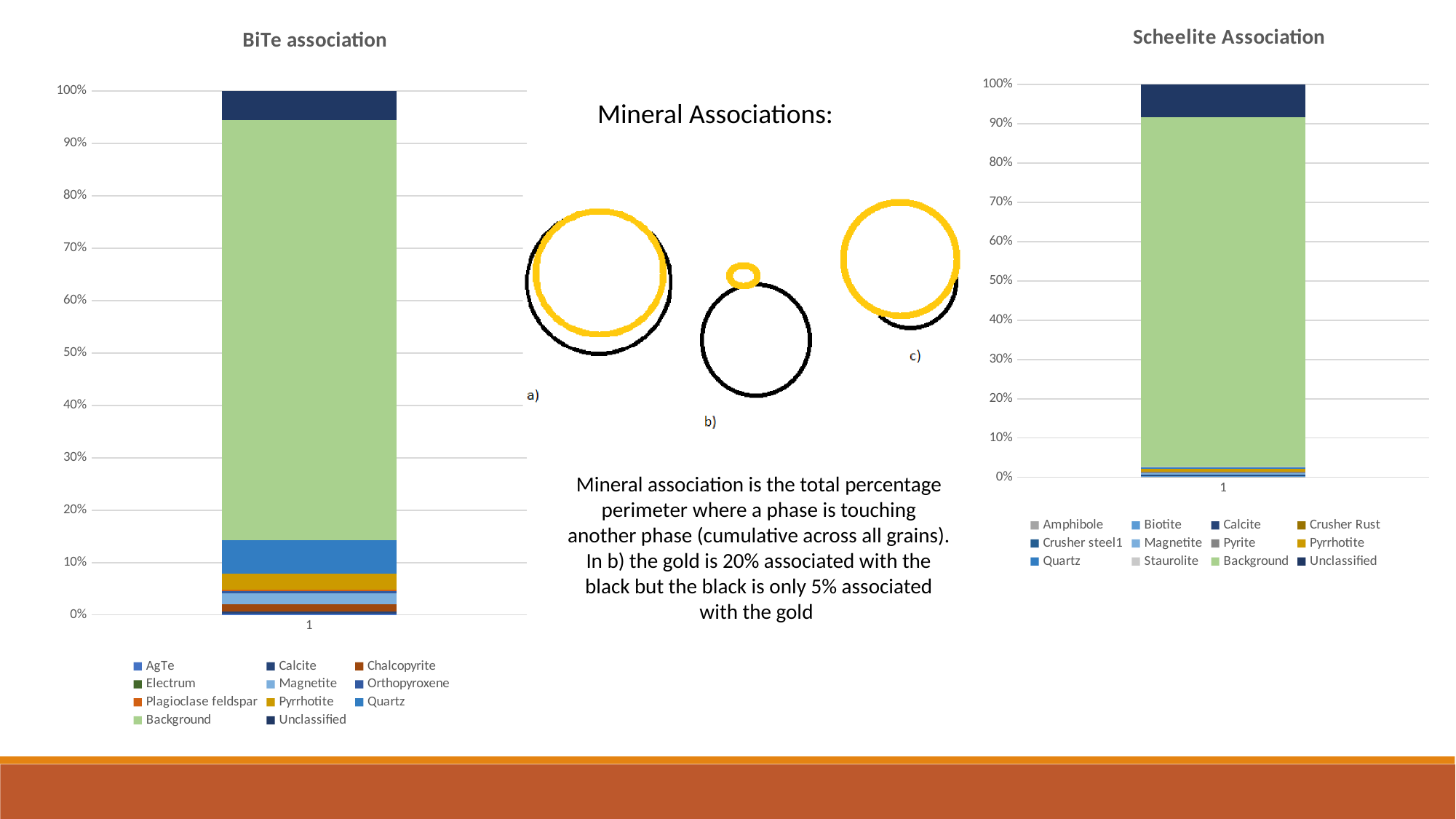
In the BiTe association chart, is the Quartz segment greater or less than 10%? less In the BiTe association chart, is the Unclassified segment greater or less than 10%? less What kind of chart is the BiTe association chart? stacked bar chart In the BiTe association chart, is the Background segment greater or less than 70%? greater In the BiTe association chart, which series takes up the largest part of the bar? Background What is the total height of the stacked bar in the BiTe association chart? 100% What kind of chart is the Scheelite Association chart? stacked bar chart How many series does the legend of the Scheelite Association chart list? 12 How many series does the legend of the BiTe association chart list? 11 In the Scheelite Association chart, which series takes up the largest part of the bar? Background How many bars are plotted in the Scheelite Association chart? 1